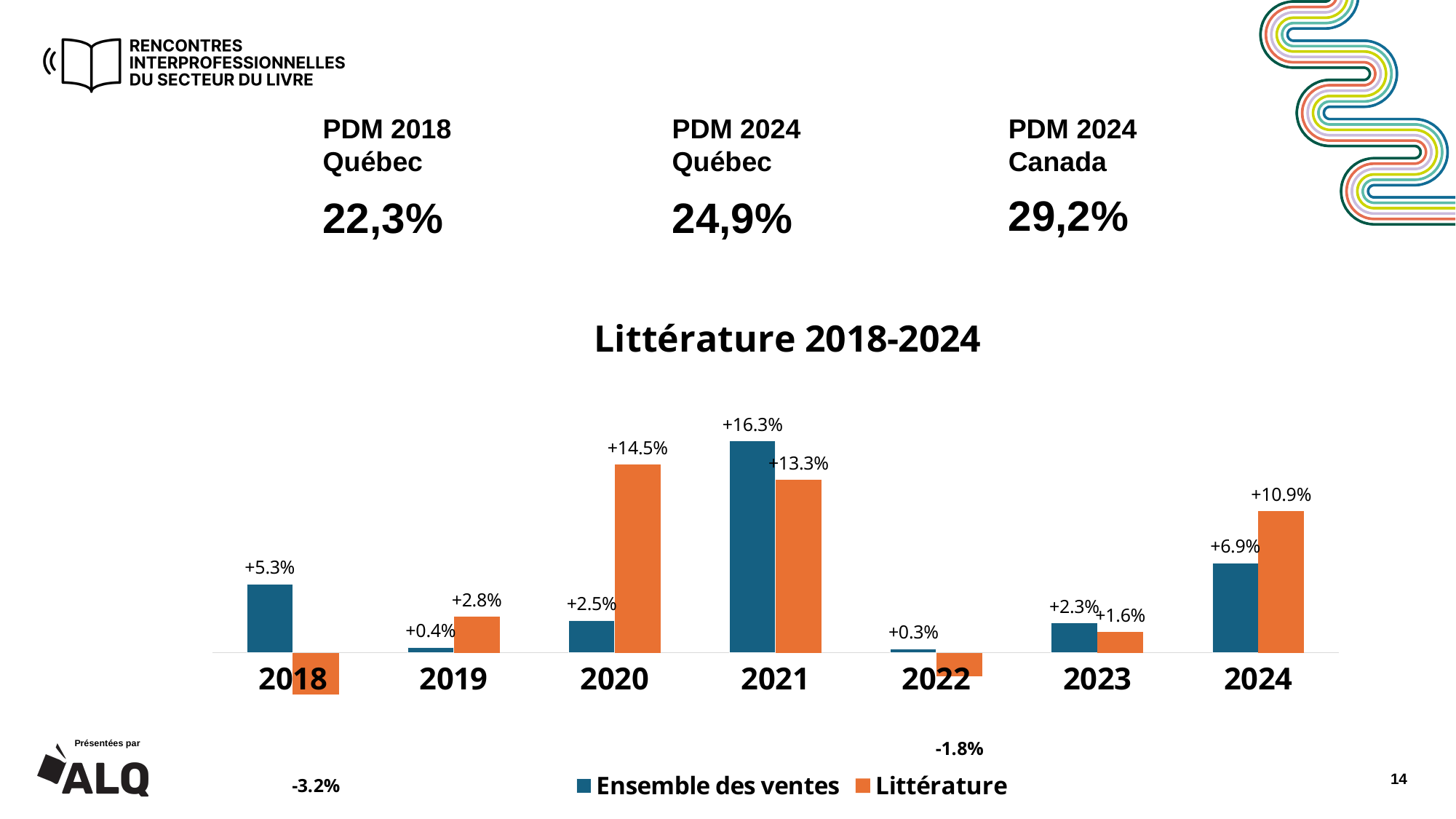
What is the value for Littérature in 2020? +14.5% How many years are shown on the x axis of the "Littérature 2018-2024" chart? 7 What is the difference between the Littérature and Ensemble des ventes values in 2020? 12.0 percentage points What is the value for Littérature in 2018? -3.2% What is the value for Ensemble des ventes in 2021? +16.3% In which year is the Littérature value lowest? 2018 In which year is the Ensemble des ventes value highest? 2021 What is the value for Littérature in 2022? -1.8% Which series is shown in orange in the "Littérature 2018-2024" chart? Littérature Which is larger in 2024, Ensemble des ventes or Littérature? Littérature How many series does the legend of the "Littérature 2018-2024" chart list? 2 What type of chart is shown under the title "Littérature 2018-2024"? bar chart